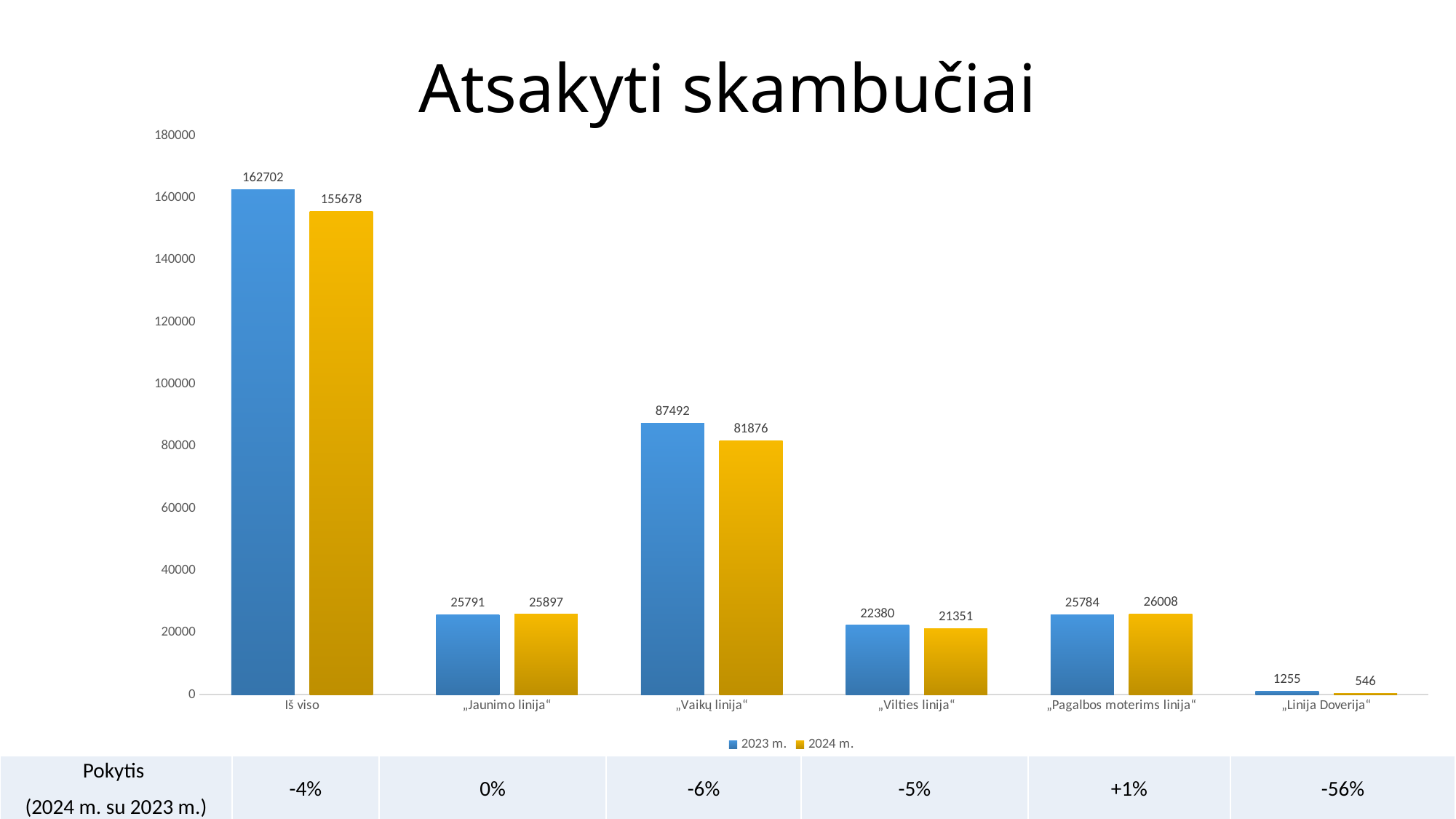
Is the 2024 m. value for „Vaikų linija“ greater or less than 100000? less How many series does the legend list? 2 Excluding Iš viso, which category has the highest value in the 2024 m. series? „Vaikų linija“ What is the value for „Vaikų linija“ in the 2023 m. series? 87492 Which category has the lowest value in the 2023 m. series? „Linija Doverija“ What is the value for „Linija Doverija“ in the 2024 m. series? 546 What is the value for „Pagalbos moterims linija“ in the 2024 m. series? 26008 What is the difference between the 2023 m. and 2024 m. values for „Vaikų linija“? 5616 For „Vilties linija“, which is larger: the 2023 m. value or the 2024 m. value? 2023 m. What is the difference between the 2023 m. and 2024 m. values for Iš viso? 7024 How many categories are shown on the x axis? 6 What type of chart is shown on the slide? bar chart